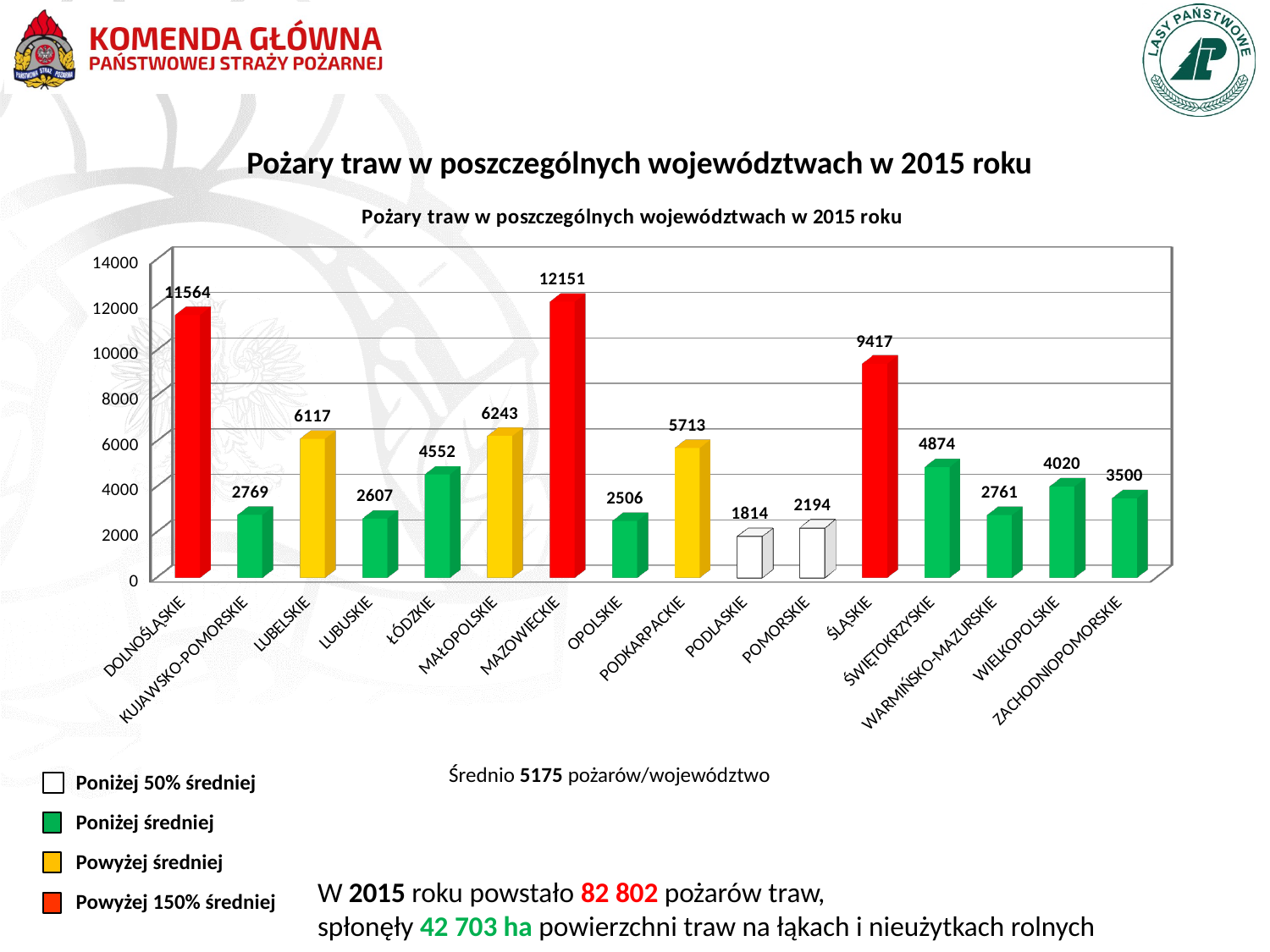
Which is larger, the value for LUBELSKIE or the value for MAŁOPOLSKIE? MAŁOPOLSKIE What is the value for MAZOWIECKIE? 12151 What kind of chart is shown on the slide? bar chart What is the value for ŚLĄSKIE? 9417 What is the title of the chart? Pożary traw w poszczególnych województwach w 2015 roku Which voivodeship has the highest number of grass fires? MAZOWIECKIE Is the value for ŚWIĘTOKRZYSKIE greater or less than 4000? greater What is the difference between the values for MAZOWIECKIE and DOLNOŚLĄSKIE? 587 How many voivodeships are shown on the x axis? 16 What colour are the bars for voivodeships above 150% of the average (Powyżej 150% średniej)? red Which voivodeship has the lowest number of grass fires? PODLASKIE What is the value for PODLASKIE? 1814